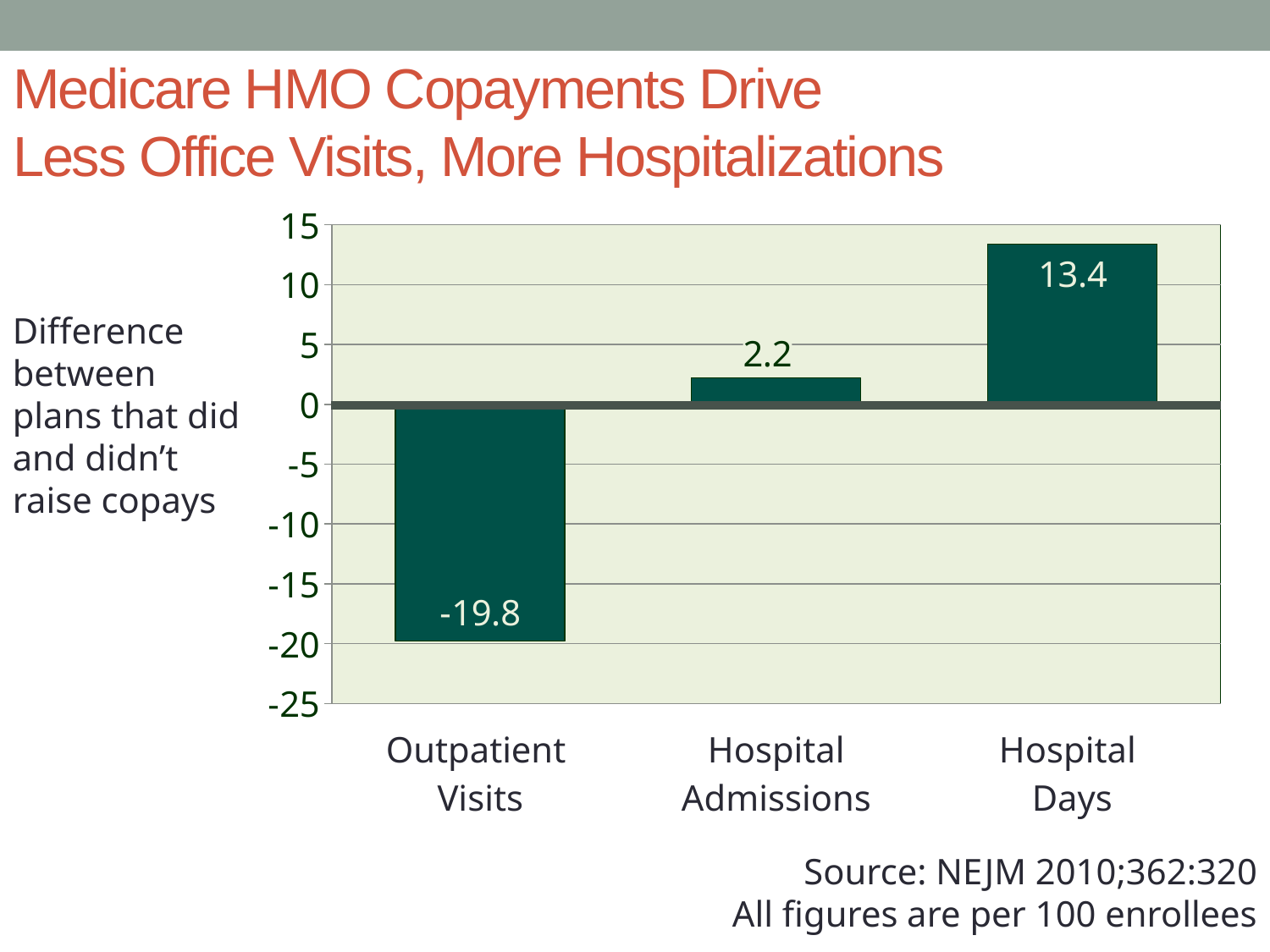
What is the value for Hospital Days? 13.4 According to the note on the slide, what unit are all figures expressed in? per 100 enrollees What kind of chart is shown on the slide? bar chart What is the value for Outpatient Visits? -19.8 How many categories are shown on the x axis? 3 Which category has a negative value? Outpatient Visits Which category has the lowest value? Outpatient Visits What is the difference between the values for Hospital Days and Hospital Admissions? 11.2 Which category has the highest value? Hospital Days What is the value for Hospital Admissions? 2.2 Is the value for Outpatient Visits greater or less than -15? less Which is larger, the value for Hospital Admissions or the value for Hospital Days? Hospital Days